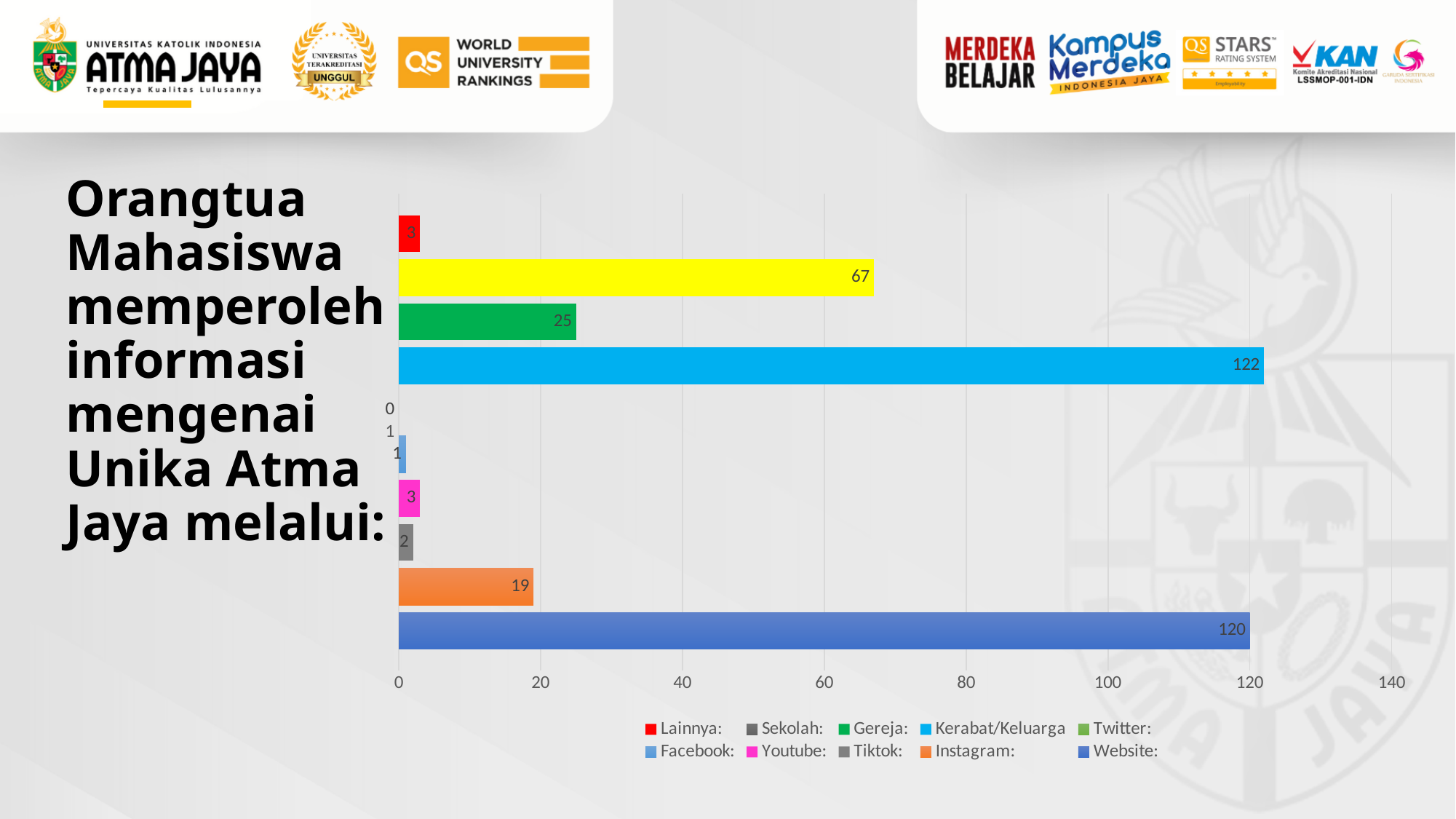
Which legend entry has the highest value? Kerabat/Keluarga How many entries does the legend list? 10 What value is shown for Kerabat/Keluarga? 122 What value is shown for Gereja? 25 What is the difference between the values for Kerabat/Keluarga and Website? 2 What kind of chart is shown on the slide? Bar chart What value is shown for Instagram? 19 Which is larger, the value for Gereja or the value for Instagram? Gereja What value is shown for Tiktok? 2 What is the difference between the values for Website and Instagram? 101 Is the value for Gereja greater or less than 20? greater What value is shown for Website? 120